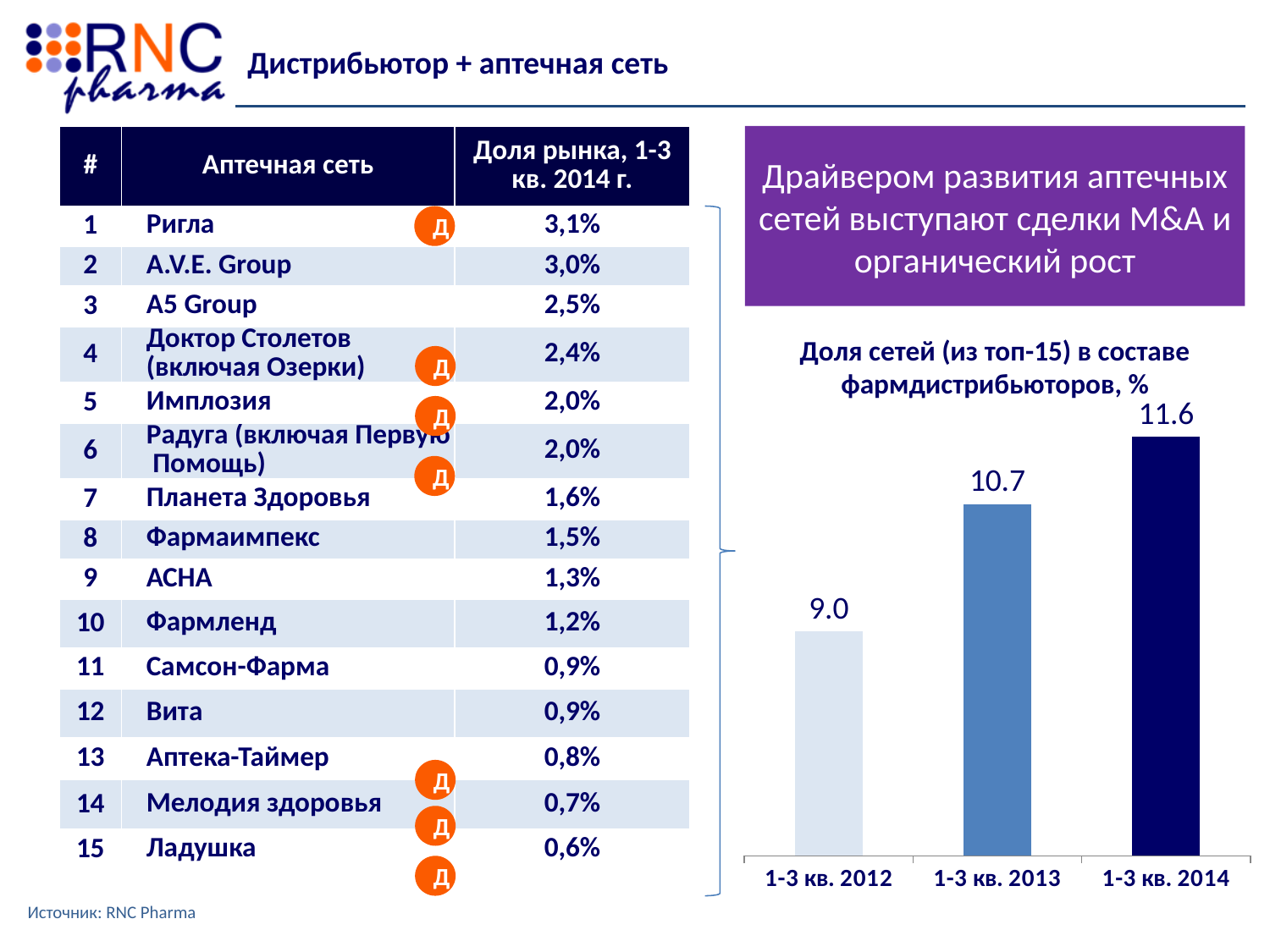
What is the value for 1-3 кв. 2013 in the chart 'Доля сетей (из топ-15) в составе фармдистрибьюторов, %'? 10.7 Do the values in the chart 'Доля сетей (из топ-15) в составе фармдистрибьюторов, %' rise or fall from 1-3 кв. 2012 to 1-3 кв. 2014? Rise Which period has the lowest value in the chart 'Доля сетей (из топ-15) в составе фармдистрибьюторов, %'? 1-3 кв. 2012 What is the value for 1-3 кв. 2014 in the chart 'Доля сетей (из топ-15) в составе фармдистрибьюторов, %'? 11.6 What kind of chart is 'Доля сетей (из топ-15) в составе фармдистрибьюторов, %'? Bar chart What is the value for 1-3 кв. 2012 in the chart 'Доля сетей (из топ-15) в составе фармдистрибьюторов, %'? 9.0 In the chart 'Доля сетей (из топ-15) в составе фармдистрибьюторов, %', what is the difference between the values for 1-3 кв. 2013 and 1-3 кв. 2012? 1.7 Which period has the highest value in the chart 'Доля сетей (из топ-15) в составе фармдистрибьюторов, %'? 1-3 кв. 2014 How many bars are shown in the chart 'Доля сетей (из топ-15) в составе фармдистрибьюторов, %'? 3 In the chart 'Доля сетей (из топ-15) в составе фармдистрибьюторов, %', which is larger: the value for 1-3 кв. 2013 or 1-3 кв. 2014? 1-3 кв. 2014 What is the title of the bar chart on the right side of the slide? Доля сетей (из топ-15) в составе фармдистрибьюторов, % In the chart 'Доля сетей (из топ-15) в составе фармдистрибьюторов, %', what is the difference between the values for 1-3 кв. 2014 and 1-3 кв. 2012? 2.6